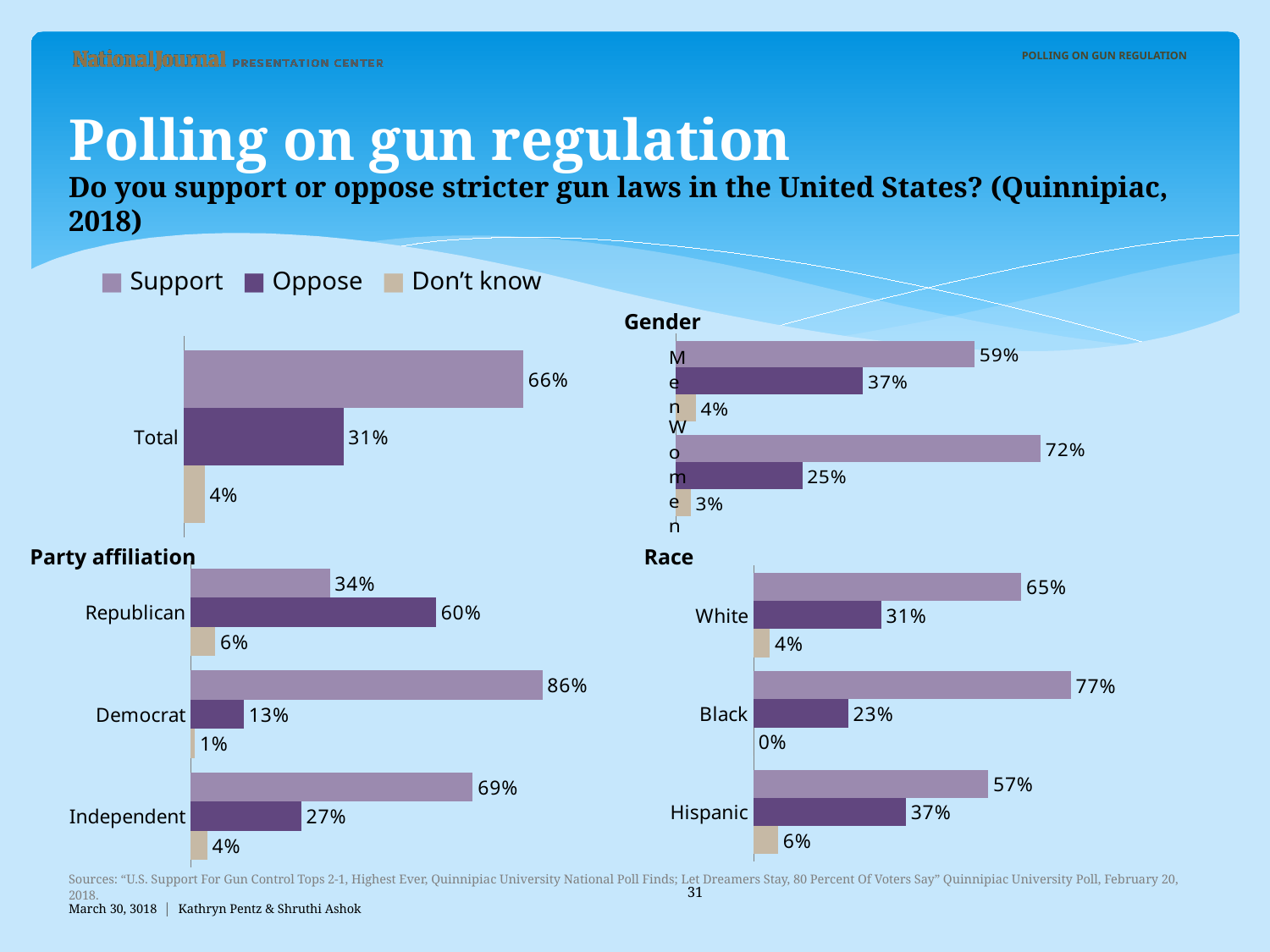
In the Total chart, what percentage of respondents oppose stricter gun laws? 31% In the Race chart, is the Oppose value larger for White or Hispanic respondents? Hispanic In the Race chart, which group has the highest Support value? Black In the Party affiliation chart, which party has the lowest Support value? Republican In the Gender chart, what is the Support value for Women? 72% In the Total chart, what percentage of respondents support stricter gun laws? 66% In the Party affiliation chart, what is the difference between the Oppose values for Republican and Democrat? 47% In the Gender chart, what is the Oppose value for Men? 37% In the Party affiliation chart, which party has the highest Support value? Democrat In the Race chart, what is the Don't know value for Black respondents? 0% How many series does the legend list? 3 What kind of chart is the Party affiliation chart? Bar chart